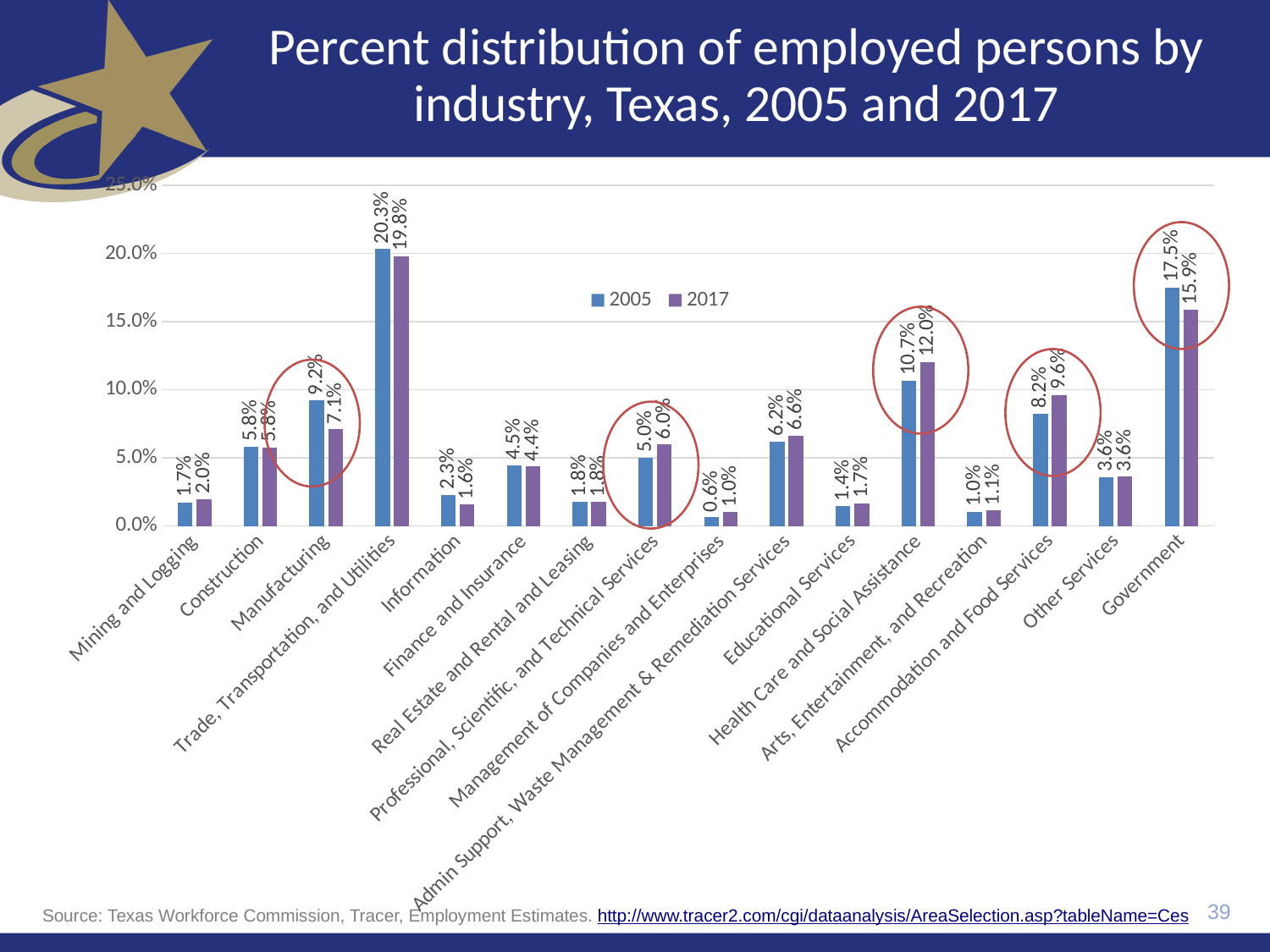
What type of chart is shown on the slide? Bar chart Is the 2017 value for Health Care and Social Assistance greater or less than 10.0%? greater What is the difference between the 2005 and 2017 values for Manufacturing? 2.1% What was the 2005 value for Health Care and Social Assistance? 10.7% How many industry categories are shown on the x axis? 16 Which industry had the highest share of employed persons in 2005? Trade, Transportation, and Utilities What was the 2017 value for Government? 15.9% Which industry had the lowest share of employed persons in 2005? Management of Companies and Enterprises How many series does the legend list? 2 Which is larger for Accommodation and Food Services, the 2005 value or the 2017 value? 2017 What was the 2017 value for Manufacturing? 7.1% What is the title of the chart? Percent distribution of employed persons by industry, Texas, 2005 and 2017